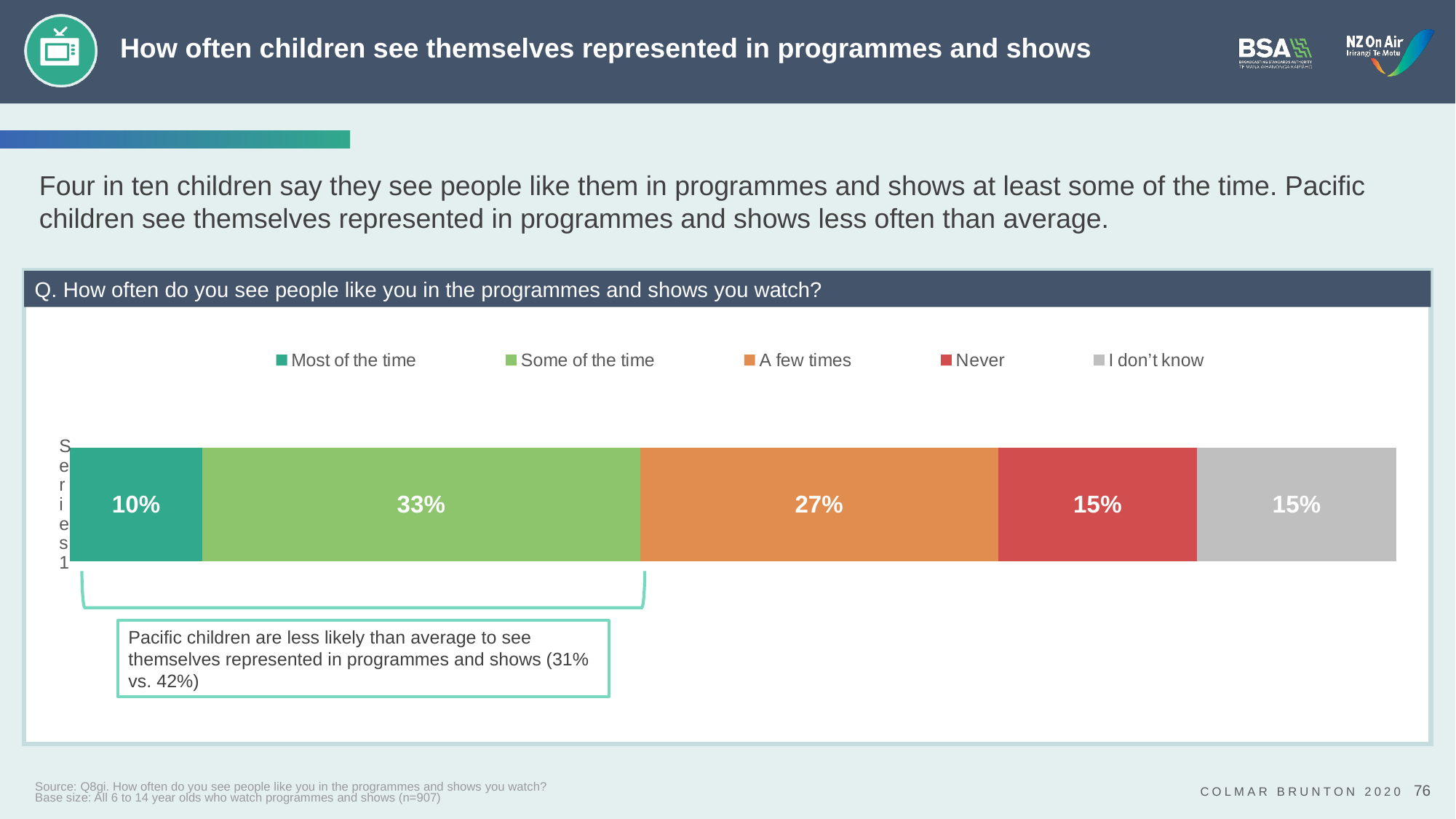
How many series does the legend list? 5 What percentage of children answered "I don't know"? 15% Which response has the largest share of the bar? Some of the time What is the combined total of "Most of the time" and "Some of the time"? 43% What percentage of children say they see people like them in programmes and shows most of the time? 10% Which is larger, the value for "A few times" or the value for "Never"? A few times What is the value for "Some of the time"? 33% What percentage of children answered "Never"? 15% What is the difference in percentage points between "Some of the time" and "A few times"? 6 Which response has the smallest share of the bar? Most of the time What is the value for "A few times"? 27% What kind of chart is shown on the slide? Stacked bar chart